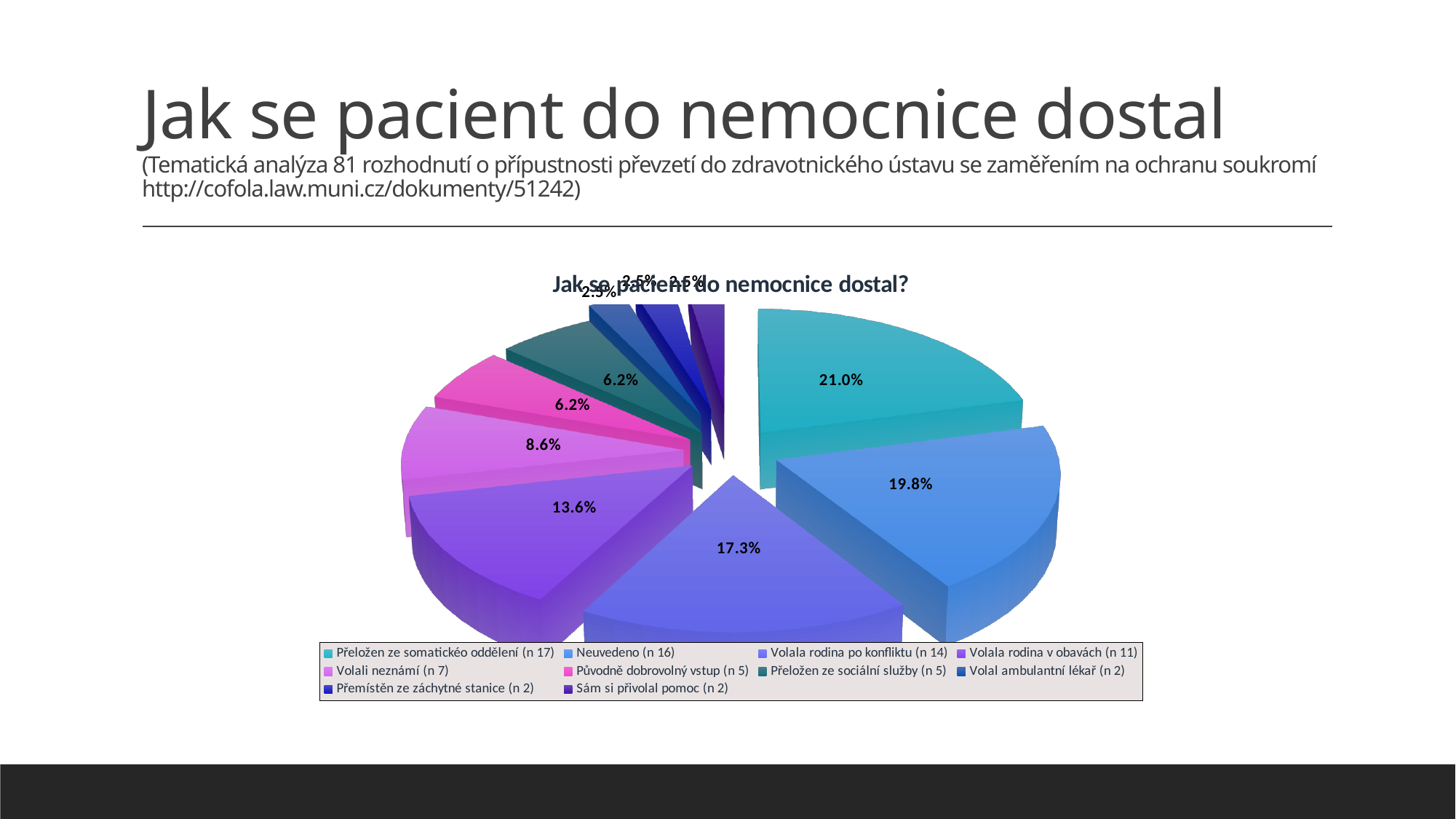
What is the title of the chart? Jak se pacient do nemocnice dostal? What percentage is shown for "Volali neznámí (n 7)"? 8.6% What percentage is shown for "Neuvedeno (n 16)"? 19.8% What is the difference in percentage points between "Přeložen ze somatickéo oddělení (n 17)" and "Neuvedeno (n 16)"? 1.2 What percentage is shown for "Původně dobrovolný vstup (n 5)"? 6.2% Which category has the largest share of the pie? Přeložen ze somatickéo oddělení (n 17) What share of the pie does "Přeložen ze somatickéo oddělení (n 17)" represent? 21.0% How many categories does the legend list? 10 What percentage is shown for "Volala rodina po konfliktu (n 14)"? 17.3% What type of chart is shown on the slide? Pie chart What percentage is shown for "Volala rodina v obavách (n 11)"? 13.6% Which is larger, the share for "Volala rodina v obavách (n 11)" or for "Volali neznámí (n 7)"? Volala rodina v obavách (n 11)